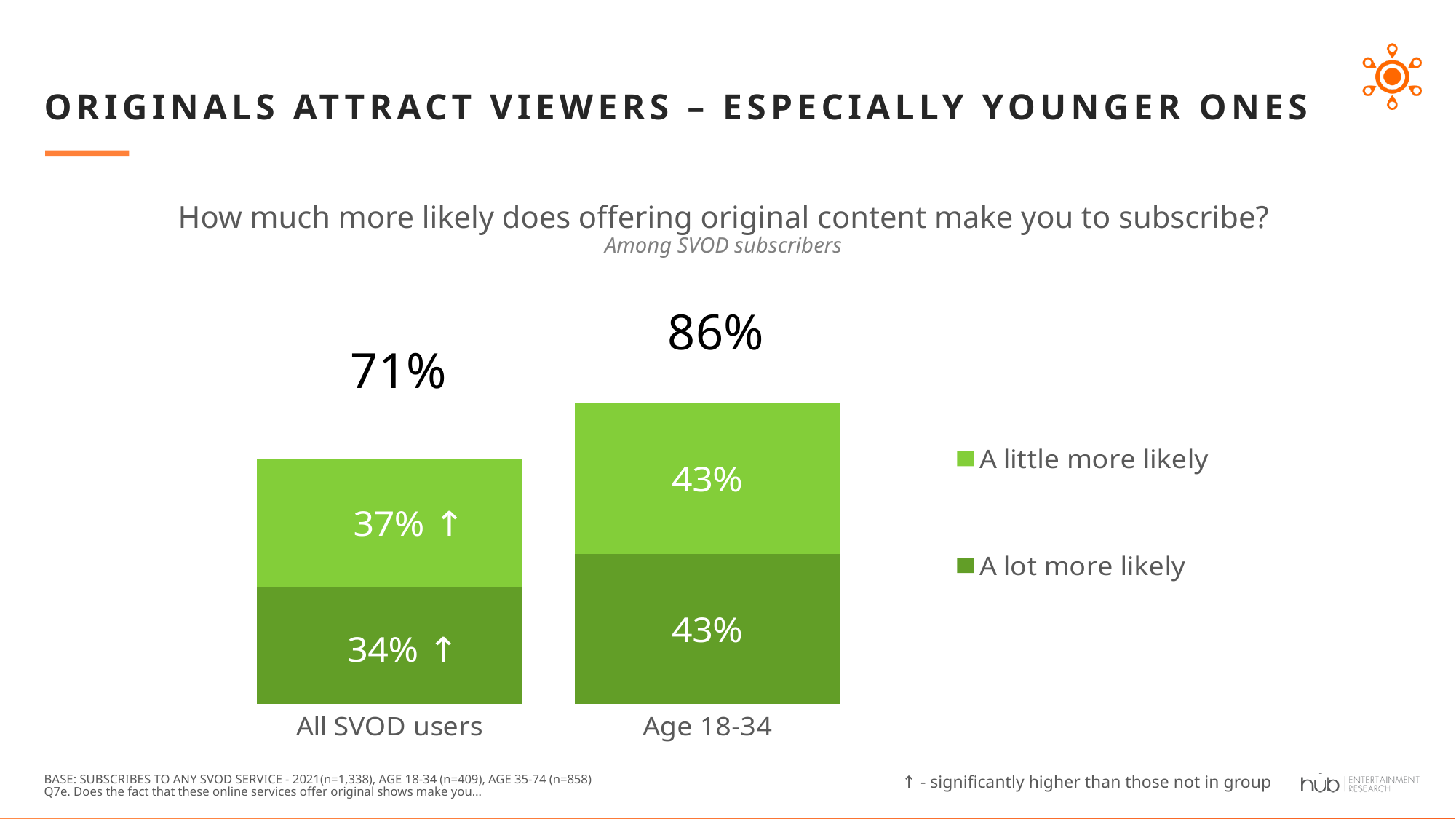
What is the total shown above the All SVOD users bar? 71% How many series does the legend list? 2 What is the total shown above the Age 18-34 bar? 86% Which legend entry is shown in the darker green colour? A lot more likely What percentage of All SVOD users said original content makes them 'A lot more likely' to subscribe? 34% Which group has the higher total, All SVOD users or Age 18-34? Age 18-34 What is the difference between the totals for Age 18-34 and All SVOD users? 15 percentage points How many groups (bars) are shown in the chart? 2 What percentage of Age 18-34 respondents said original content makes them 'A little more likely' to subscribe? 43% What is the 'A little more likely' value for All SVOD users? 37% What kind of chart is shown on the slide? Stacked bar chart What is the difference between the 'A lot more likely' values for Age 18-34 and All SVOD users? 9 percentage points